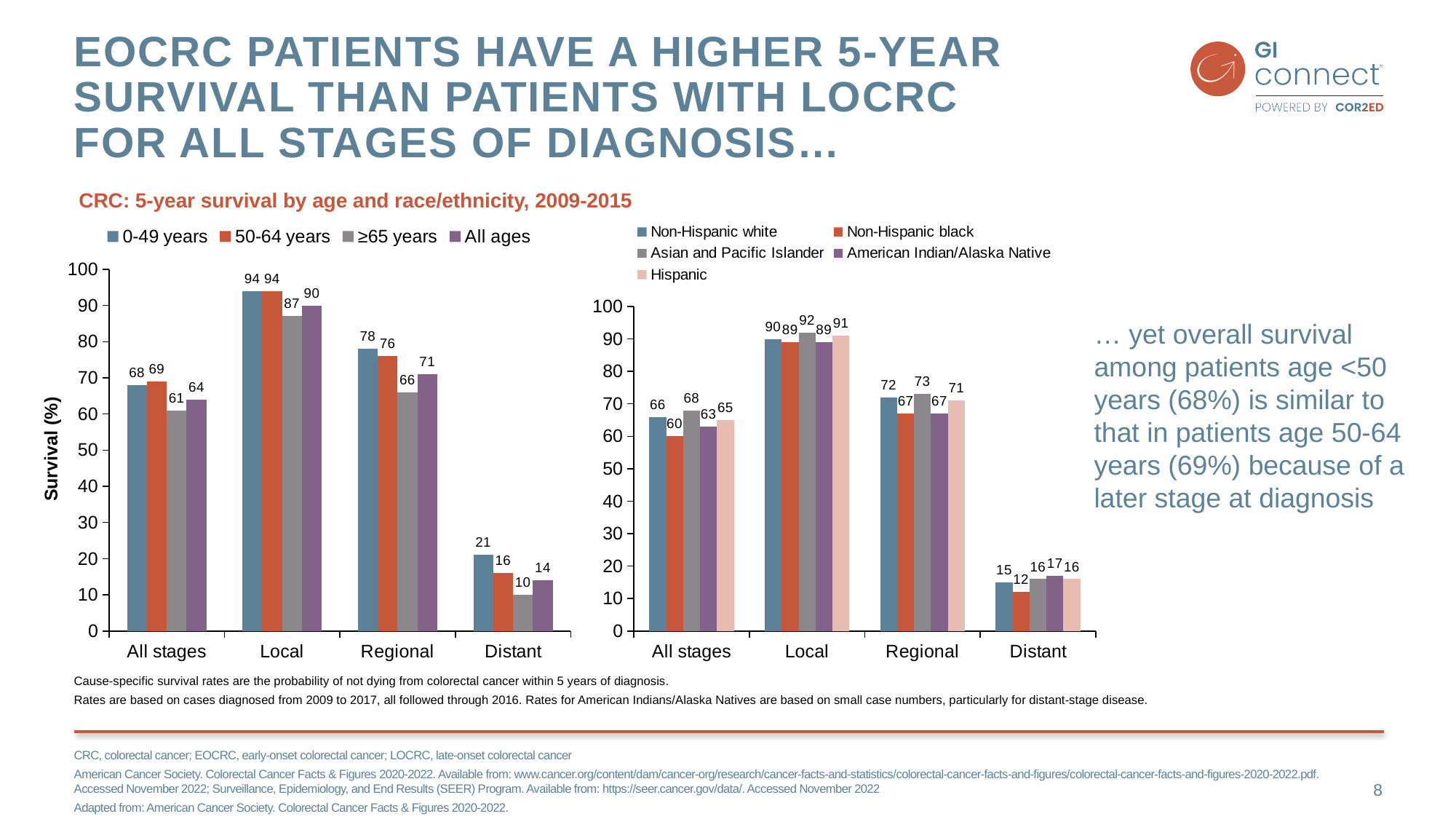
In the left chart (survival by age), which is larger at All stages: the 50-64 years value or the All ages value? 50-64 years In the left chart (survival by age), which age group has the lowest survival at the Distant stage? ≥65 years In the right chart (survival by race/ethnicity), what is the value for Asian and Pacific Islander at the Local stage? 92 In the left chart (survival by age), what is the 5-year survival for 0-49 years at the Distant stage? 21 In the left chart (survival by age), what is the value for ≥65 years at the Regional stage? 66 In the right chart (survival by race/ethnicity), what is the difference between the Non-Hispanic white and Non-Hispanic black values at the Regional stage? 5 How many series does the legend of the right chart (survival by race/ethnicity) list? 5 What type of chart is the left chart (survival by age)? Bar chart In the right chart (survival by race/ethnicity), what is the value for Non-Hispanic black at All stages? 60 In the left chart (survival by age), what is the difference between the 0-49 years and ≥65 years values at the Regional stage? 12 How many stage categories are shown on the x axis of the left chart (survival by age)? 4 In the right chart (survival by race/ethnicity), which group has the highest survival at All stages? Asian and Pacific Islander